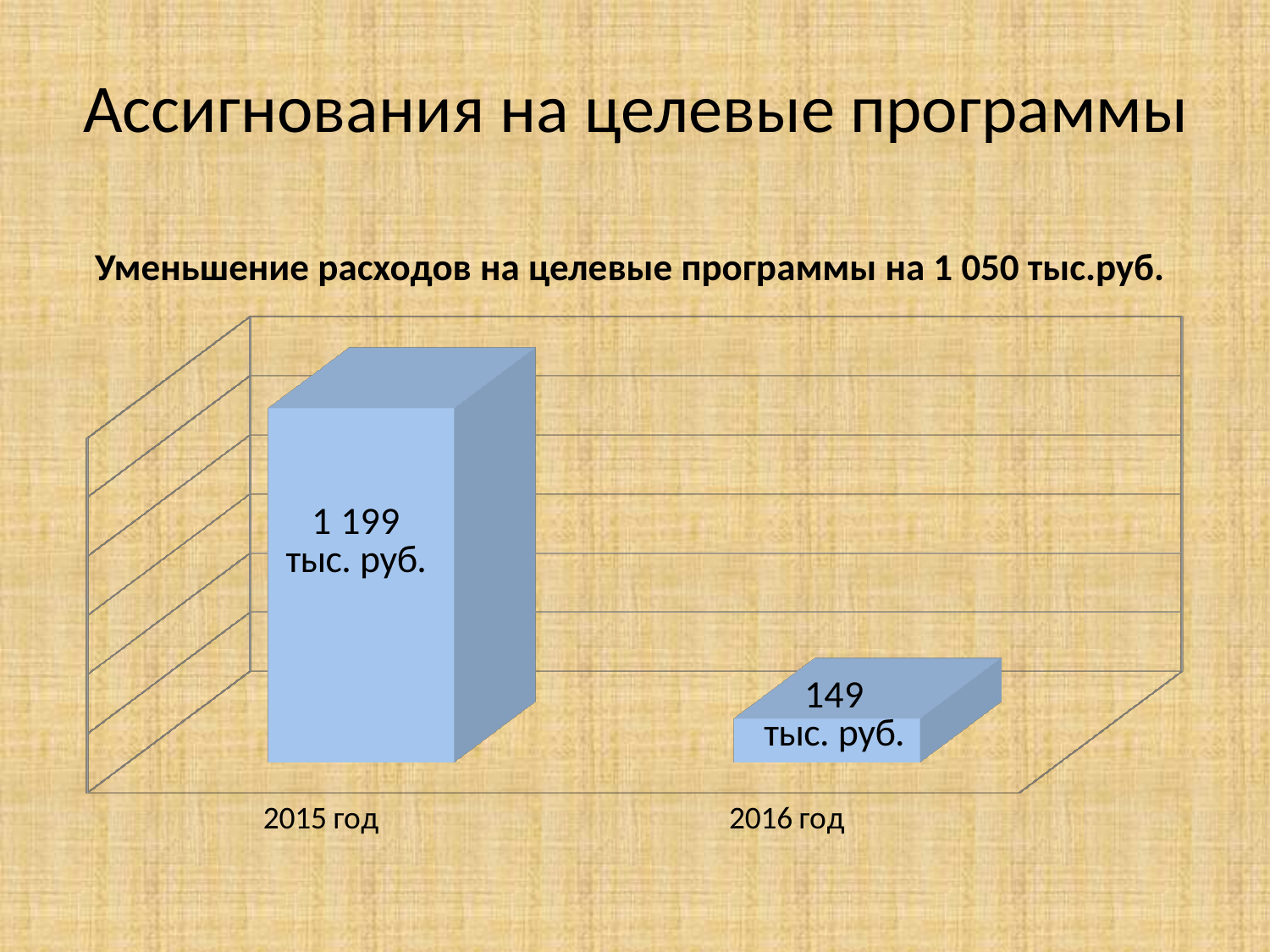
Which year has the lowest value? 2016 год Which is larger, the value for 2015 год or the value for 2016 год? 2015 год Do the values rise or fall from 2015 год to 2016 год? Fall What kind of chart is shown on the slide? Bar chart How many categories are shown on the chart? 2 What colour are the bars on the chart? Blue What is the difference between the values for 2015 год and 2016 год? 1 050 тыс. руб. What is the value for 2016 год? 149 тыс. руб. Which year has the highest value? 2015 год What is the title of the slide? Ассигнования на целевые программы What is the value for 2015 год? 1 199 тыс. руб.